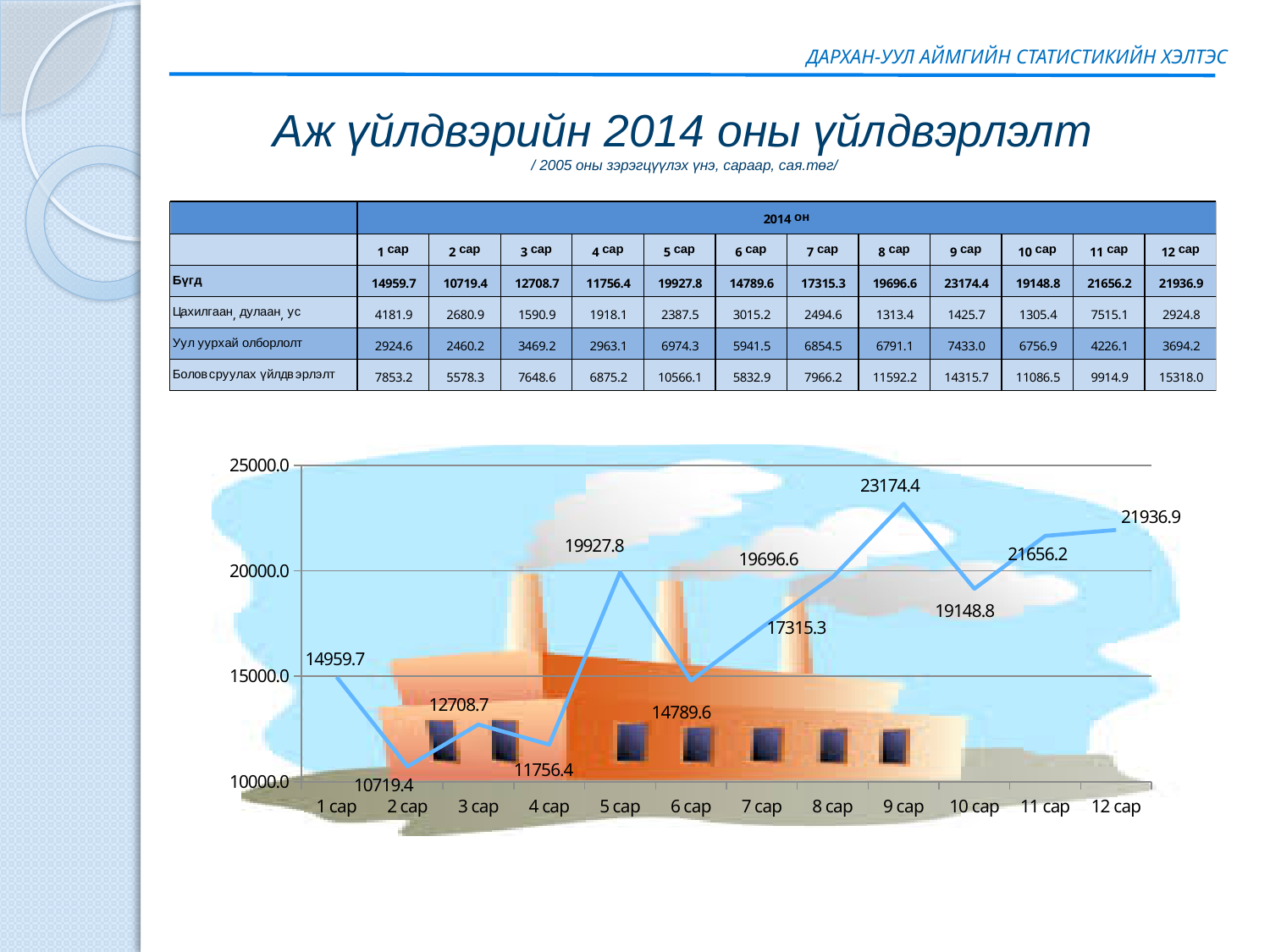
What is the value plotted for 10 сар? 19148.8 How many months are plotted on the x axis of the chart? 12 What is the value plotted for 5 сар? 19927.8 Which month has the lowest value on the chart? 2 сар Does the value rise or fall from 10 сар to 12 сар? rise What is the difference between the values for 9 сар and 2 сар? 12455.0 What type of chart is shown on the slide? line chart What is the difference between the values for 5 сар and 4 сар? 8171.4 Which month has the highest value on the chart? 9 сар What is the value plotted for 1 сар? 14959.7 Which is larger, the value for 7 сар or the value for 6 сар? 7 сар Is the value for 3 сар greater or less than 15000.0? less